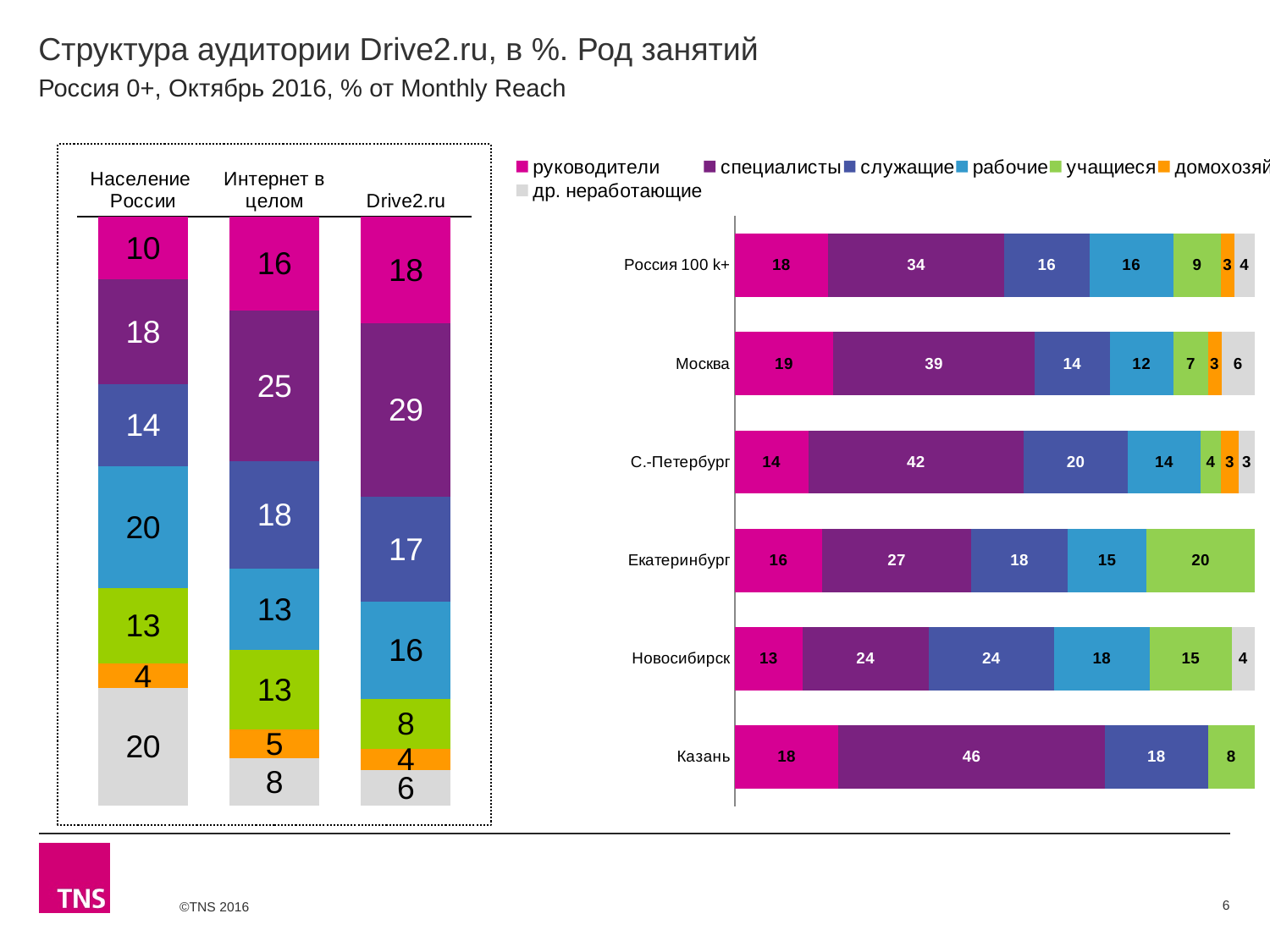
In the right chart, which city or region has the lowest value for руководители? Новосибирск In the right chart, is the value for учащиеся larger for Екатеринбург or for Москва? Екатеринбург In the right chart, what is the value for специалисты for Казань? 46 In the left chart, what is the difference between the специалисты values for Drive2.ru and Население России? 11 How many cities or regions are shown in the right chart? 6 In the right chart, which city or region has the highest value for специалисты? Казань In the left chart, what is the value for рабочие in the Население России column? 20 In the left chart, which column has the highest value for учащиеся? Население России and Интернет в целом (both 13) What type of chart is the right chart? Stacked horizontal bar chart In the left chart, what is the value for специалисты in the Drive2.ru column? 29 In the right chart, what is the value for служащие for С.-Петербург? 20 In the left chart, what is the value for руководители in the Интернет в целом column? 16